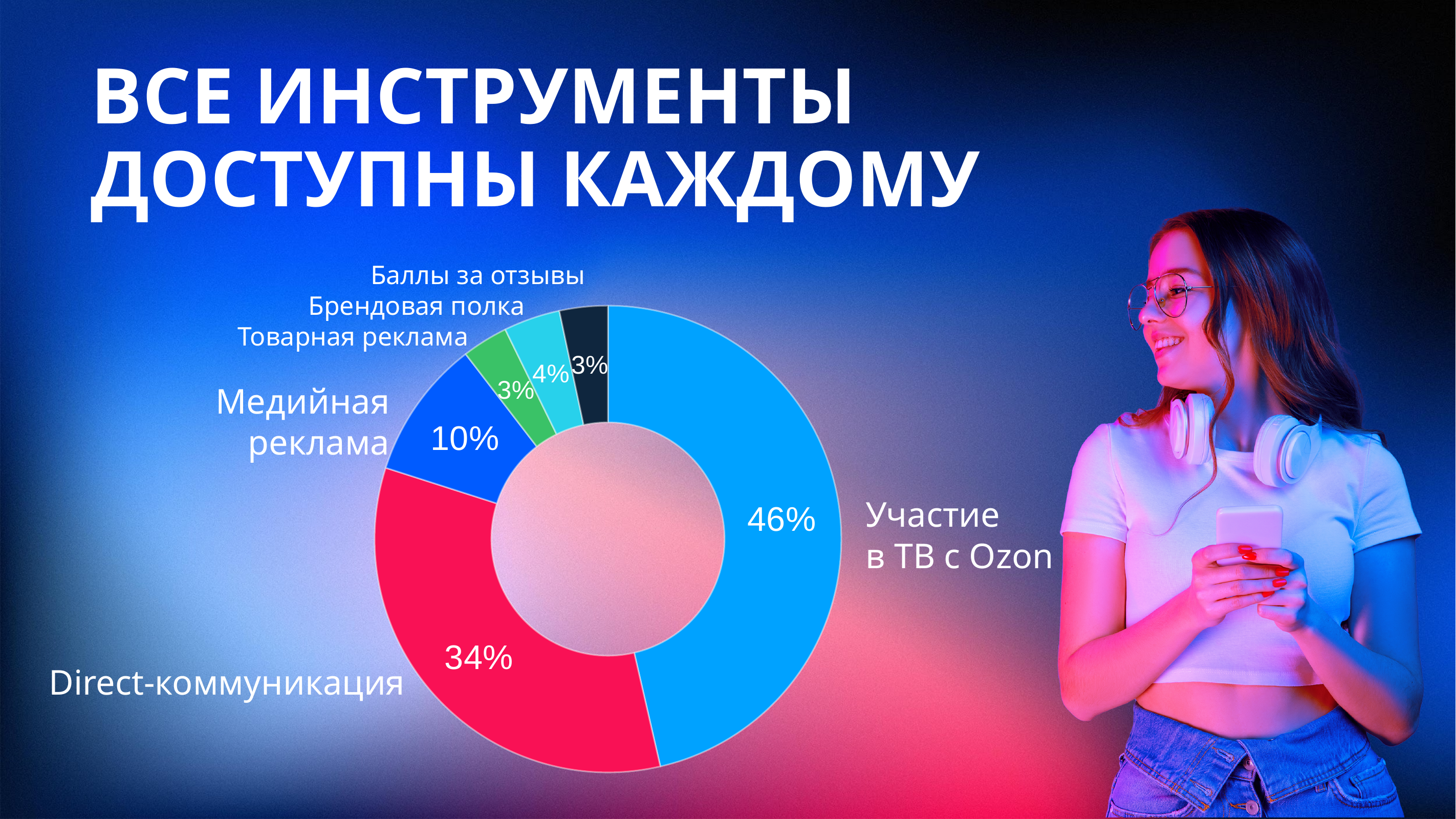
What share does Direct-коммуникация have in the chart? 34% What share does Участие в ТВ с Ozon have in the chart? 46% Which is larger: the share of Direct-коммуникация or the share of Медийная реклама? Direct-коммуникация What share does Брендовая полка have in the chart? 4% Which category has the largest share in the chart? Участие в ТВ с Ozon What colour is the Direct-коммуникация segment of the chart? Red (pink-red) What kind of chart is shown on the slide? Doughnut (pie) chart What is the difference in percentage points between Участие в ТВ с Ozon and Direct-коммуникация? 12 percentage points How many categories (segments) does the chart show? 6 What is the combined share of Участие в ТВ с Ozon and Direct-коммуникация? 80% Is the share of Медийная реклама greater or less than 20%? less What share does Медийная реклама have in the chart? 10%